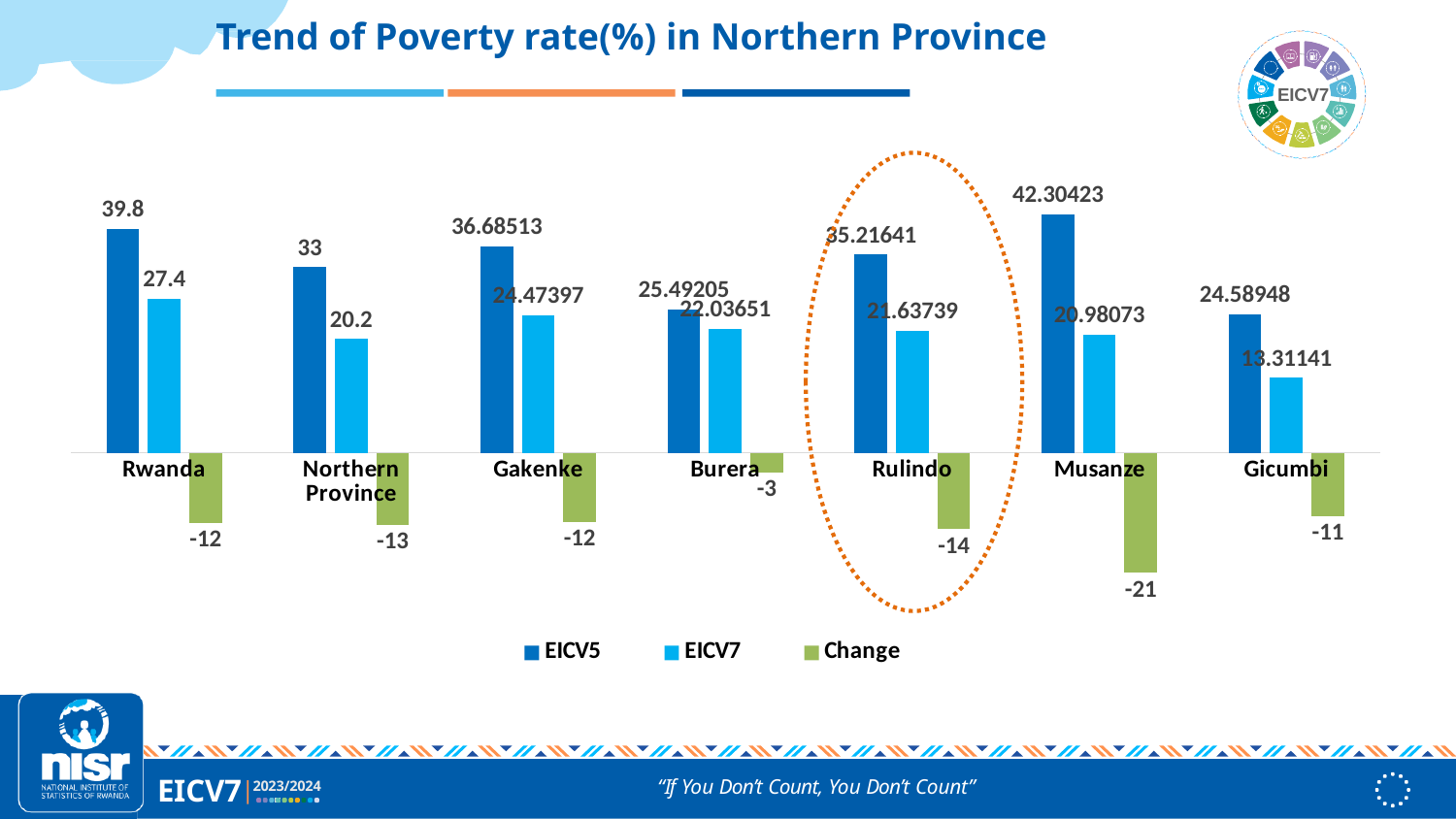
What is the Change value for Rulindo? -14 How many categories are shown on the x axis? 7 Which is larger, the EICV7 value for Burera or the EICV7 value for Rulindo? Burera Which category has the largest negative Change value? Musanze What is the difference between the EICV5 and EICV7 values for Rwanda? 12.4 Which category has the highest EICV5 poverty rate? Musanze Which category has the lowest EICV7 poverty rate? Gicumbi How many series does the legend list? 3 What kind of chart is shown on the slide? Bar chart What is the EICV7 poverty rate for Gicumbi? 13.31141 What is the EICV5 poverty rate for Musanze? 42.30423 What is the EICV7 value for Northern Province? 20.2